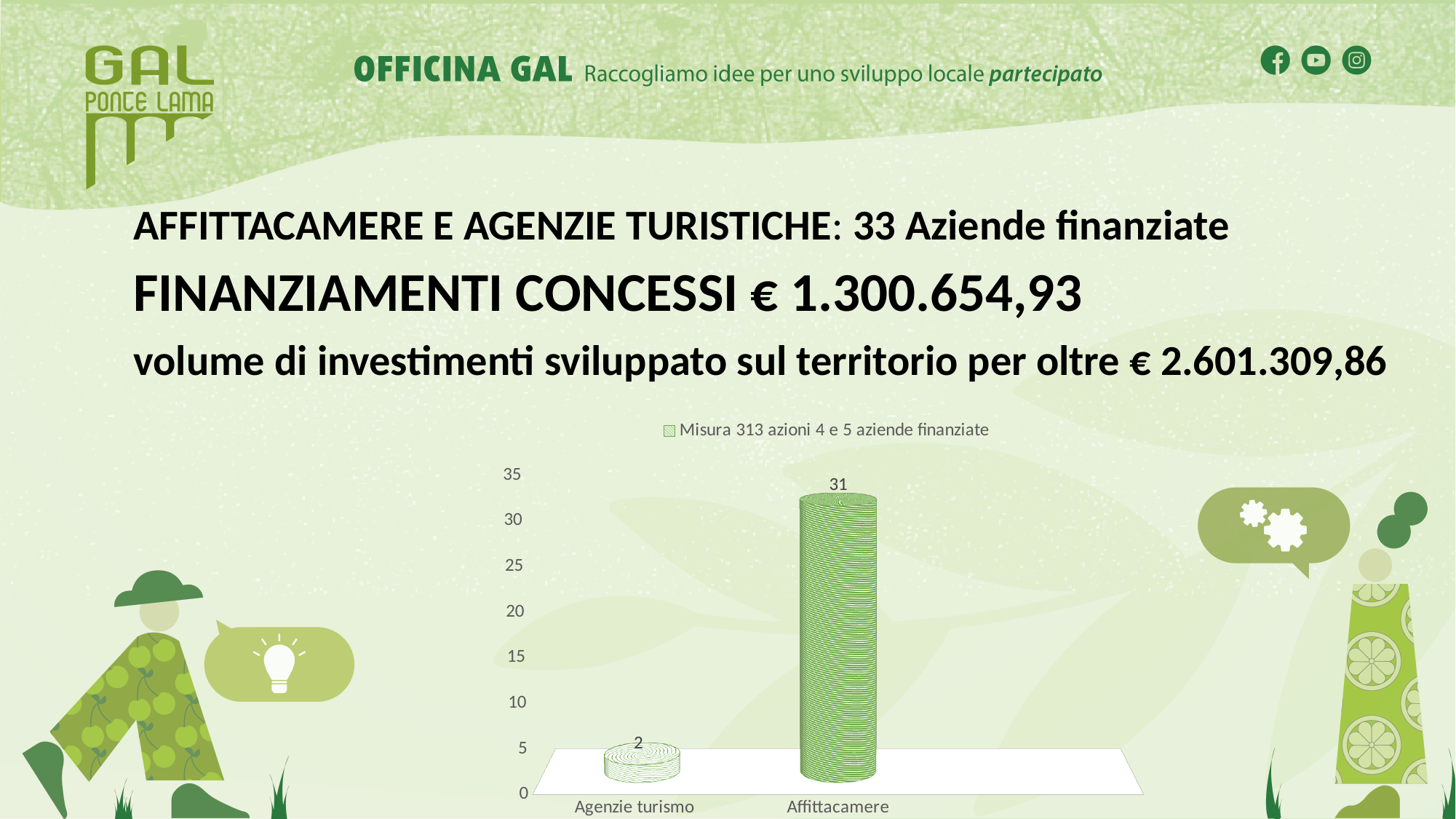
What is the value for Agenzie turismo? 2 Is the value for Affittacamere greater or less than 25? greater What is the difference between the values for Affittacamere and Agenzie turismo? 29 What is the legend entry of the chart? Misura 313 azioni 4 e 5 aziende finanziate Which category has the highest value? Affittacamere Which is larger, the value for Agenzie turismo or the value for Affittacamere? Affittacamere Is the value for Agenzie turismo greater or less than 5? less What kind of chart is shown on the slide? bar chart How many categories are shown on the x axis of the chart? 2 Which category has the lowest value? Agenzie turismo What is the value for Affittacamere? 31 How many series does the chart legend list? 1